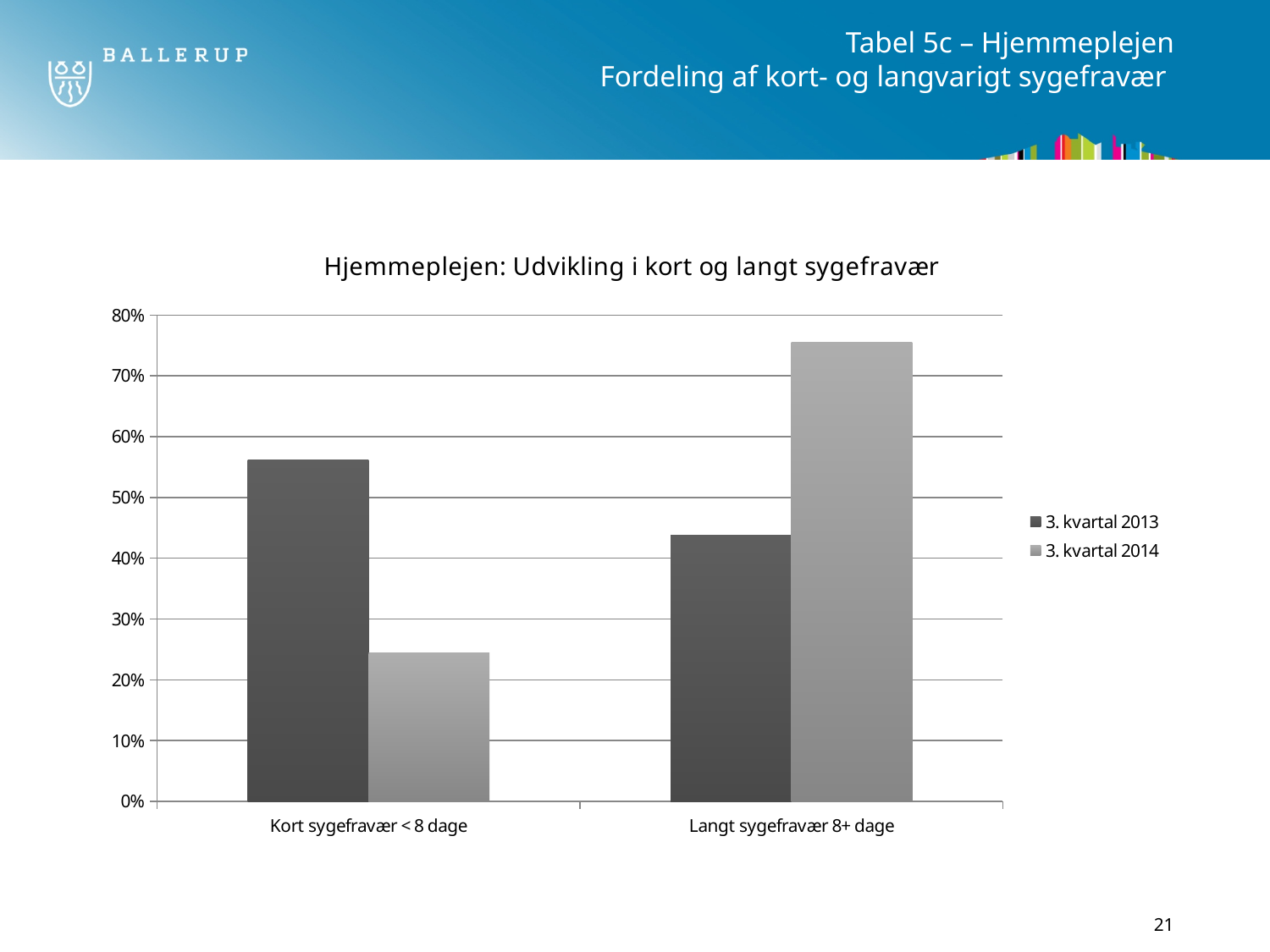
What kind of chart is shown on the slide? bar chart How many categories are shown on the x axis? 2 What is the title of the chart? Hjemmeplejen: Udvikling i kort og langt sygefravær Is the value for 3. kvartal 2013 in Kort sygefravær < 8 dage greater or less than 50%? greater Which bar is the tallest in the chart? 3. kvartal 2014 for Langt sygefravær 8+ dage For Langt sygefravær 8+ dage, which series has the larger value, 3. kvartal 2013 or 3. kvartal 2014? 3. kvartal 2014 How many series does the legend list? 2 Is the value for 3. kvartal 2014 in Kort sygefravær < 8 dage greater or less than 30%? less Which two series are listed in the legend? 3. kvartal 2013 and 3. kvartal 2014 For Kort sygefravær < 8 dage, which series has the larger value, 3. kvartal 2013 or 3. kvartal 2014? 3. kvartal 2013 Is the value for 3. kvartal 2013 in Langt sygefravær 8+ dage greater or less than 50%? less